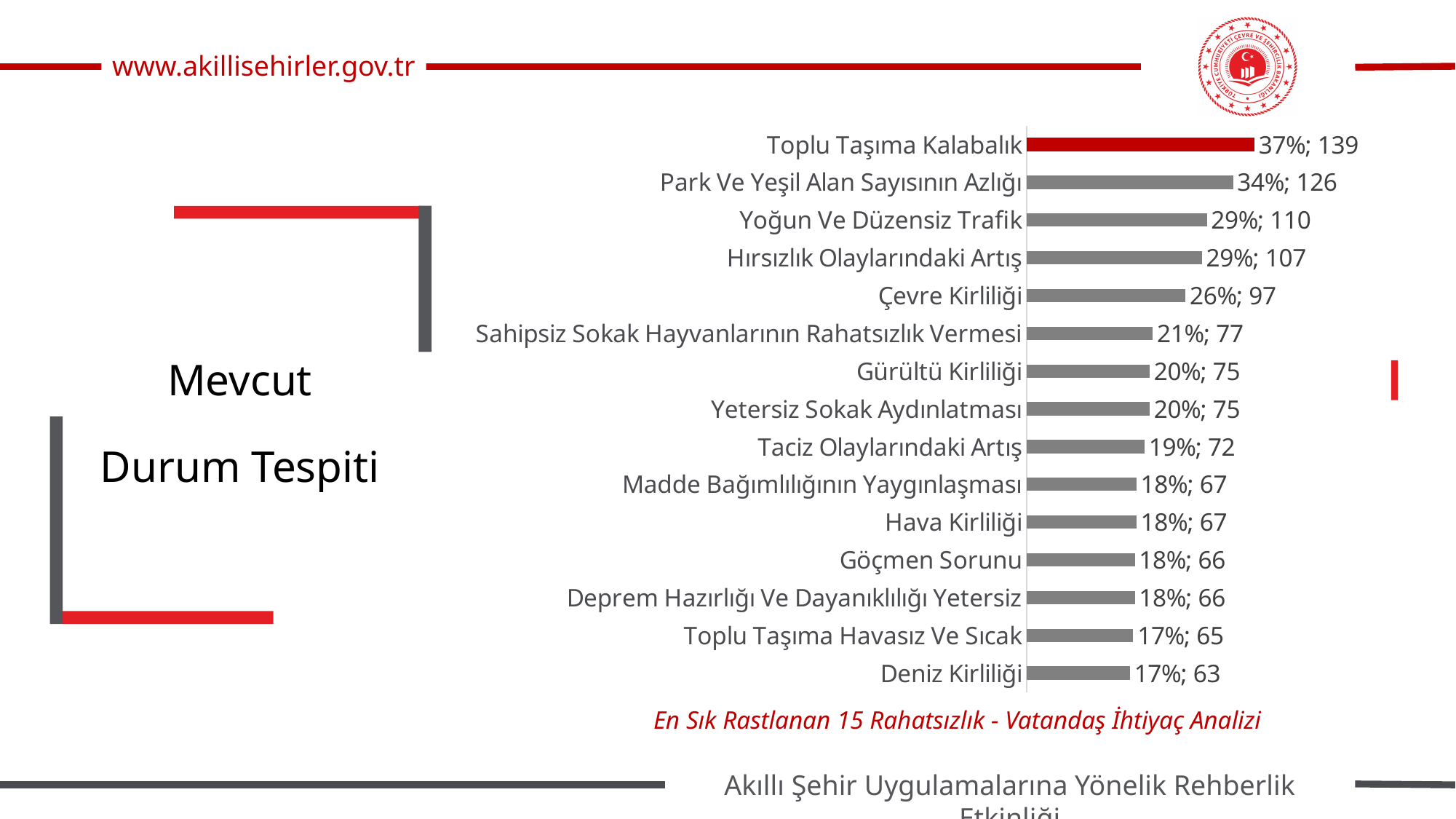
What is the caption shown below the chart? En Sık Rastlanan 15 Rahatsızlık - Vatandaş İhtiyaç Analizi How many categories are shown in the chart? 15 What percentage is shown for Sahipsiz Sokak Hayvanlarının Rahatsızlık Vermesi? 21% What count is shown for Çevre Kirliliği? 97 Which bar is coloured red rather than grey? Toplu Taşıma Kalabalık Which category has the lowest value in the chart? Deniz Kirliliği What is the difference in count between Toplu Taşıma Kalabalık (139) and Park Ve Yeşil Alan Sayısının Azlığı (126)? 13 What is the data label shown for Toplu Taşıma Kalabalık? 37%; 139 What is the difference in count between Yoğun Ve Düzensiz Trafik and Hırsızlık Olaylarındaki Artış? 3 Which category has the highest value in the chart? Toplu Taşıma Kalabalık Which has a larger count, Taciz Olaylarındaki Artış or Hava Kirliliği? Taciz Olaylarındaki Artış What kind of chart is shown on the slide? Bar chart